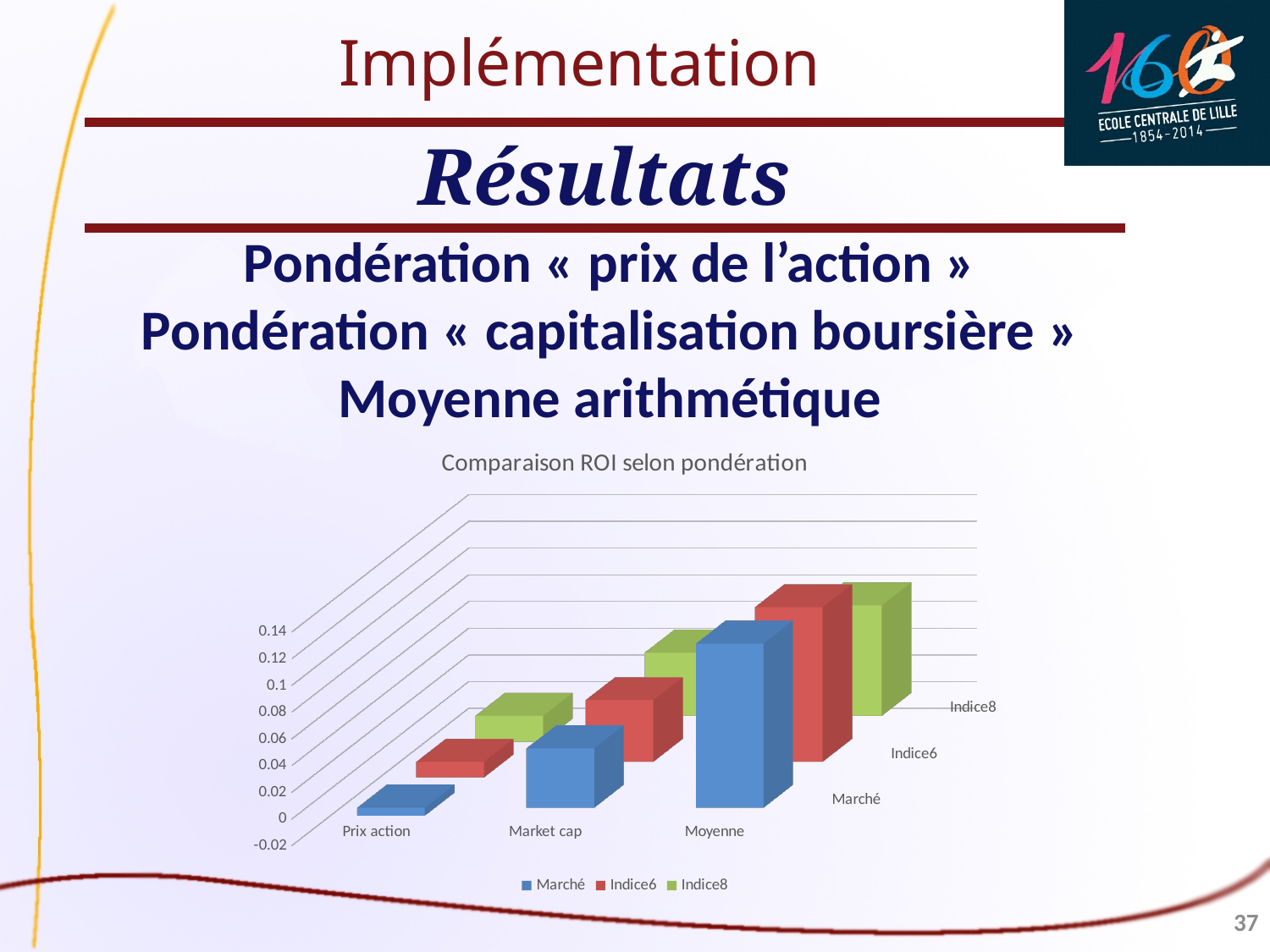
Is the Marché value for Moyenne greater or less than 0.1? greater Is the Marché value for Prix action greater or less than 0.04? less For the Marché series, which category has the lowest value? Prix action For the Marché series, which is larger: the value for Market cap or the value for Moyenne? Moyenne Which series are listed in the chart legend? Marché, Indice6, Indice8 For the Marché series, which category has the highest value? Moyenne What is the title of the chart? Comparaison ROI selon pondération Do the Indice6 values rise or fall from Prix action to Moyenne along the x axis? rise What kind of chart is shown on the slide? bar chart How many series does the chart legend list? 3 Do the Marché values rise or fall from Prix action to Moyenne along the x axis? rise How many categories are shown on the x axis of the chart? 3